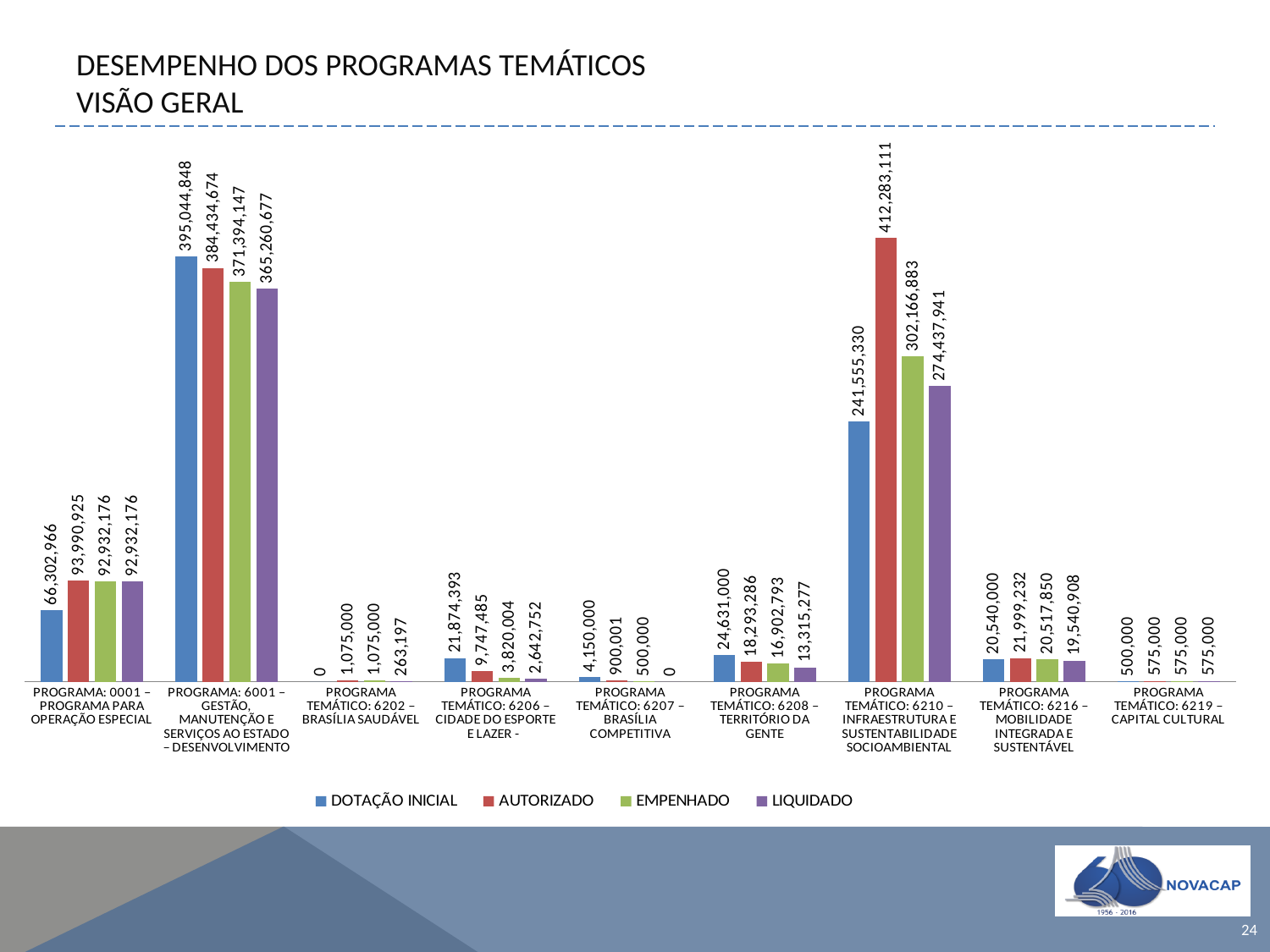
How many programs (categories) are shown on the x axis? 9 For PROGRAMA TEMÁTICO: 6206 – CIDADE DO ESPORTE E LAZER, which is larger: DOTAÇÃO INICIAL or AUTORIZADO? DOTAÇÃO INICIAL What is the AUTORIZADO value for PROGRAMA TEMÁTICO: 6210 – INFRAESTRUTURA E SUSTENTABILIDADE SOCIOAMBIENTAL? 412,283,111 Which program has the highest AUTORIZADO value? PROGRAMA TEMÁTICO: 6210 – INFRAESTRUTURA E SUSTENTABILIDADE SOCIOAMBIENTAL What is the LIQUIDADO value for PROGRAMA TEMÁTICO: 6202 – BRASÍLIA SAUDÁVEL? 263,197 What is the EMPENHADO value for PROGRAMA TEMÁTICO: 6208 – TERRITÓRIO DA GENTE? 16,902,793 What is the DOTAÇÃO INICIAL value for PROGRAMA: 6001 – GESTÃO, MANUTENÇÃO E SERVIÇOS AO ESTADO – DESENVOLVIMENTO? 395,044,848 What kind of chart is shown on the slide? Bar chart How many series does the legend list? 4 What is the difference between the DOTAÇÃO INICIAL and the AUTORIZADO values for PROGRAMA: 0001 – PROGRAMA PARA OPERAÇÃO ESPECIAL? 27,687,959 Which program has the lowest DOTAÇÃO INICIAL value? PROGRAMA TEMÁTICO: 6202 – BRASÍLIA SAUDÁVEL Which series is shown in green in the legend? EMPENHADO